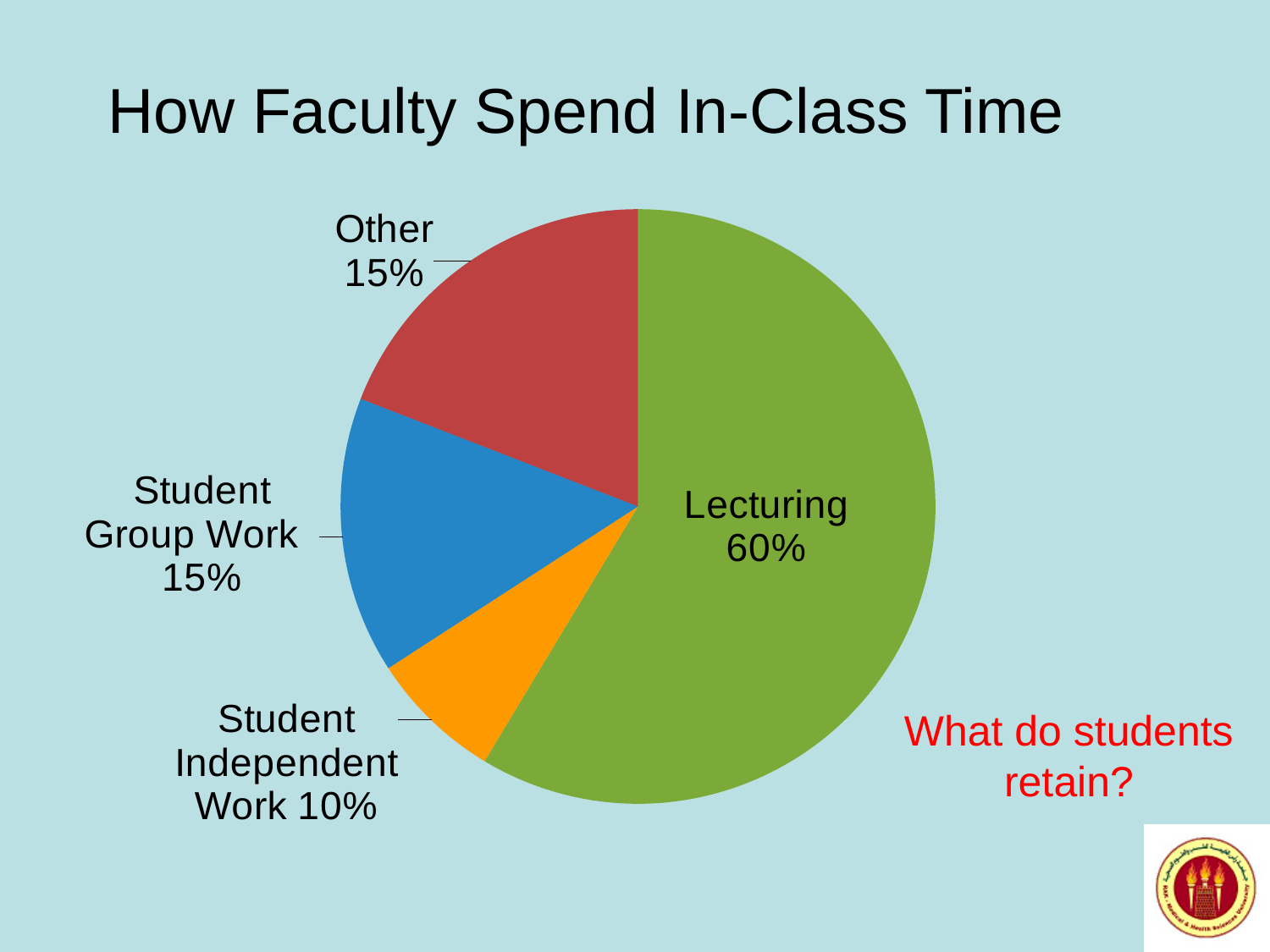
What percentage of in-class time is spent on Lecturing? 60% What percentage of in-class time is spent on Student Group Work? 15% What kind of chart is shown on the slide? Pie chart Which category takes the smallest share of in-class time? Student Independent Work Which category takes the largest share of in-class time? Lecturing How many categories are shown in the pie chart? 4 What is the title of the chart? How Faculty Spend In-Class Time What colour is the Lecturing slice? Green What percentage of in-class time is spent on Student Independent Work? 10% How many percentage points larger is Lecturing than Student Group Work? 45 What percentage of in-class time is labelled Other? 15% Which is larger, Student Group Work or Student Independent Work? Student Group Work